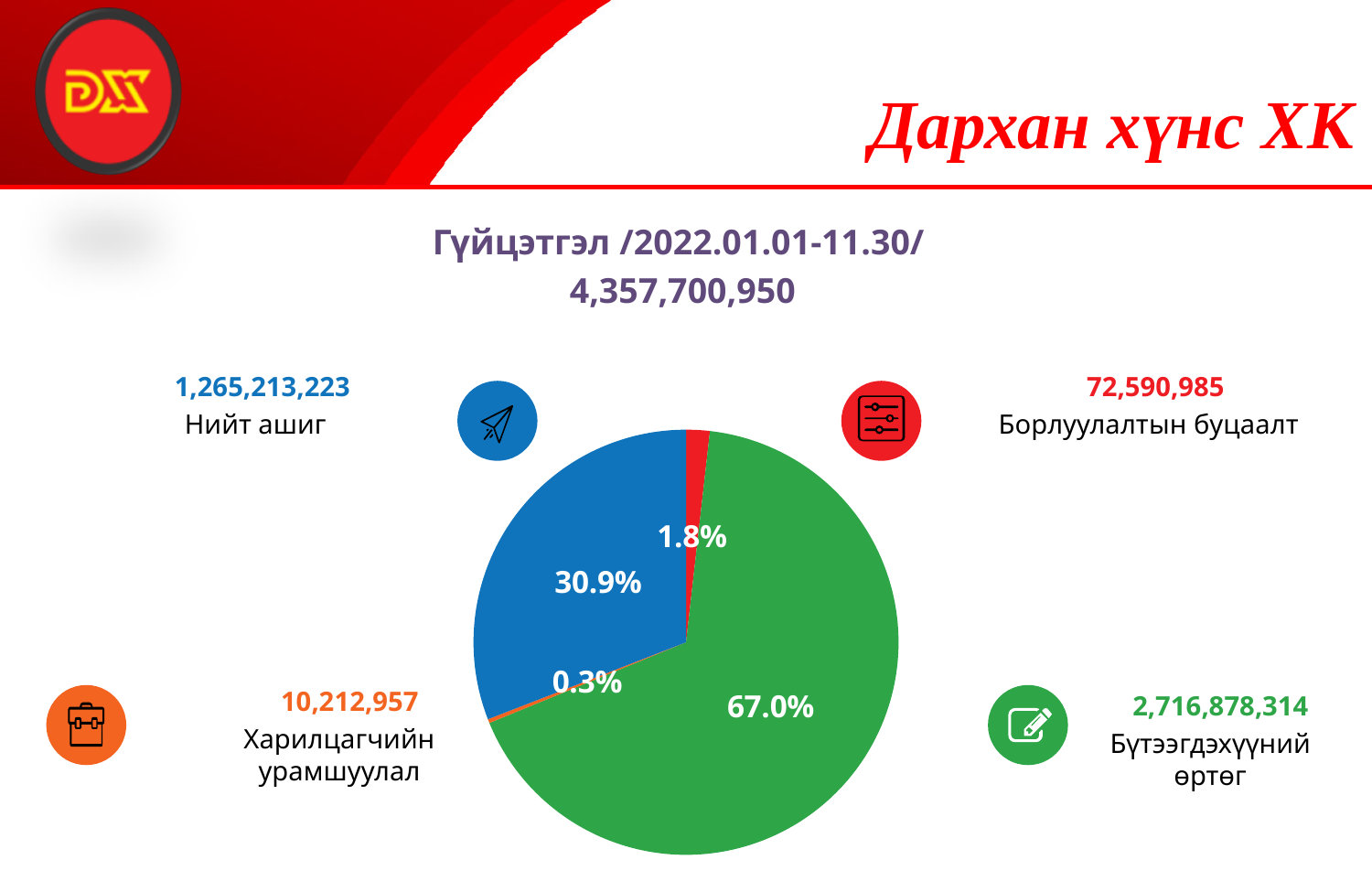
Which category has the largest slice of the pie? Бүтээгдэхүүний өртөг Which category has the smallest slice of the pie? Харилцагчийн урамшуулал How many slices does the pie chart have? 4 What share of the pie does the smallest slice (Харилцагчийн урамшуулал) represent? 0.3% What total value is shown under the chart title Гүйцэтгэл /2022.01.01-11.30/? 4,357,700,950 What share of the pie does the red slice (Борлуулалтын буцаалт) represent? 1.8% What is the value shown for Нийт ашиг? 1,265,213,223 What is the difference in percentage points between the 67.0% slice and the 30.9% slice? 36.1 What kind of chart is shown on the slide? pie chart What share of the pie does the green slice (Бүтээгдэхүүний өртөг) represent? 67.0% What is the value shown for Бүтээгдэхүүний өртөг? 2,716,878,314